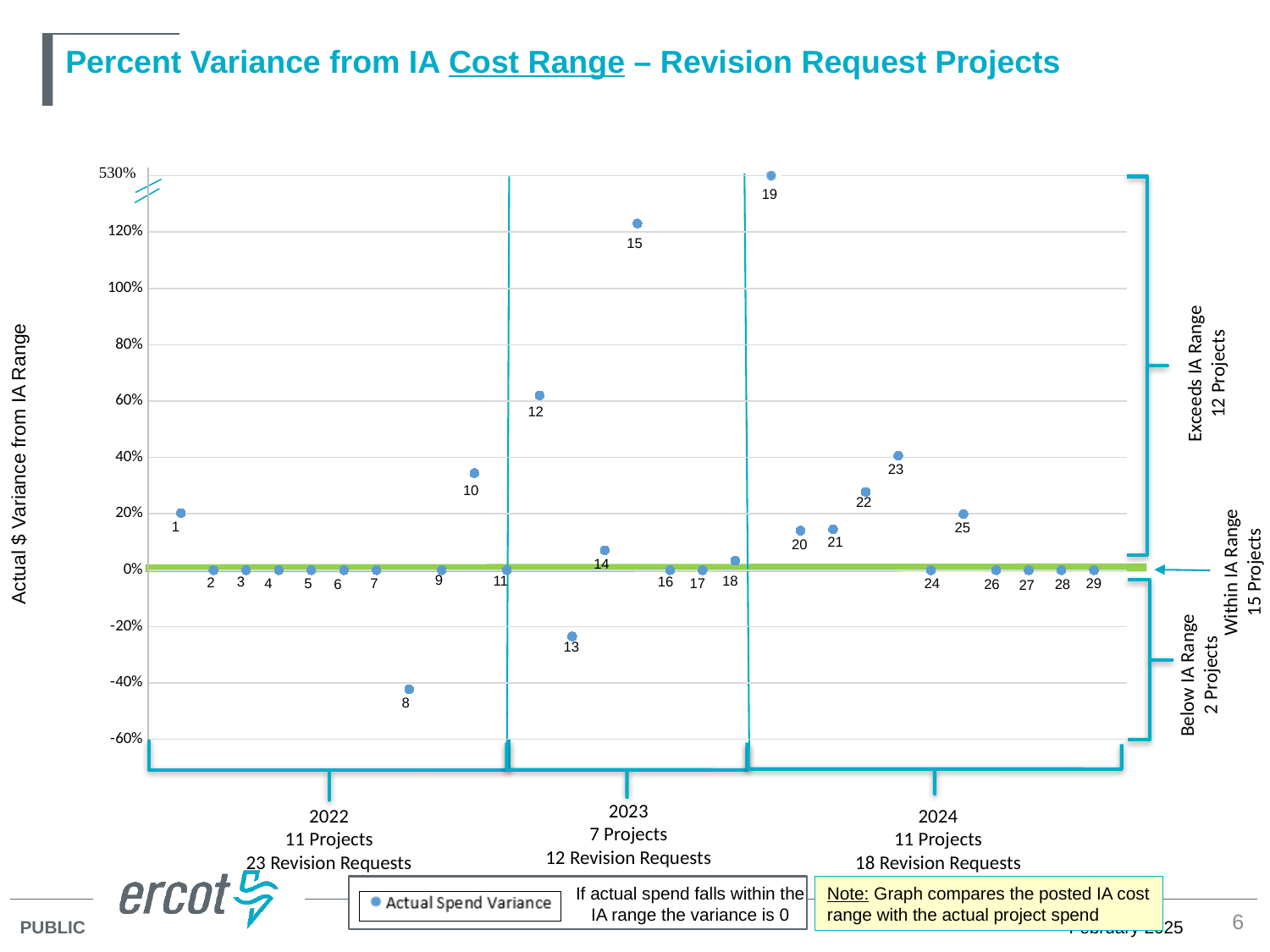
Is the value for project 8 less or greater than -20%? less How many projects are plotted on the chart? 29 What kind of chart is shown on the slide? scatter chart How many series does the legend list? 1 What is the Actual Spend Variance for project 2? 0% Which has the larger Actual Spend Variance, project 15 or project 12? project 15 What is the Actual Spend Variance for project 19? 530% Which project number has the lowest Actual Spend Variance? 8 Is the value for project 23 greater or less than 20%? greater What is the legend entry for the plotted series? Actual Spend Variance Is the value for project 15 greater or less than 100%? greater Which project number has the highest Actual Spend Variance? 19